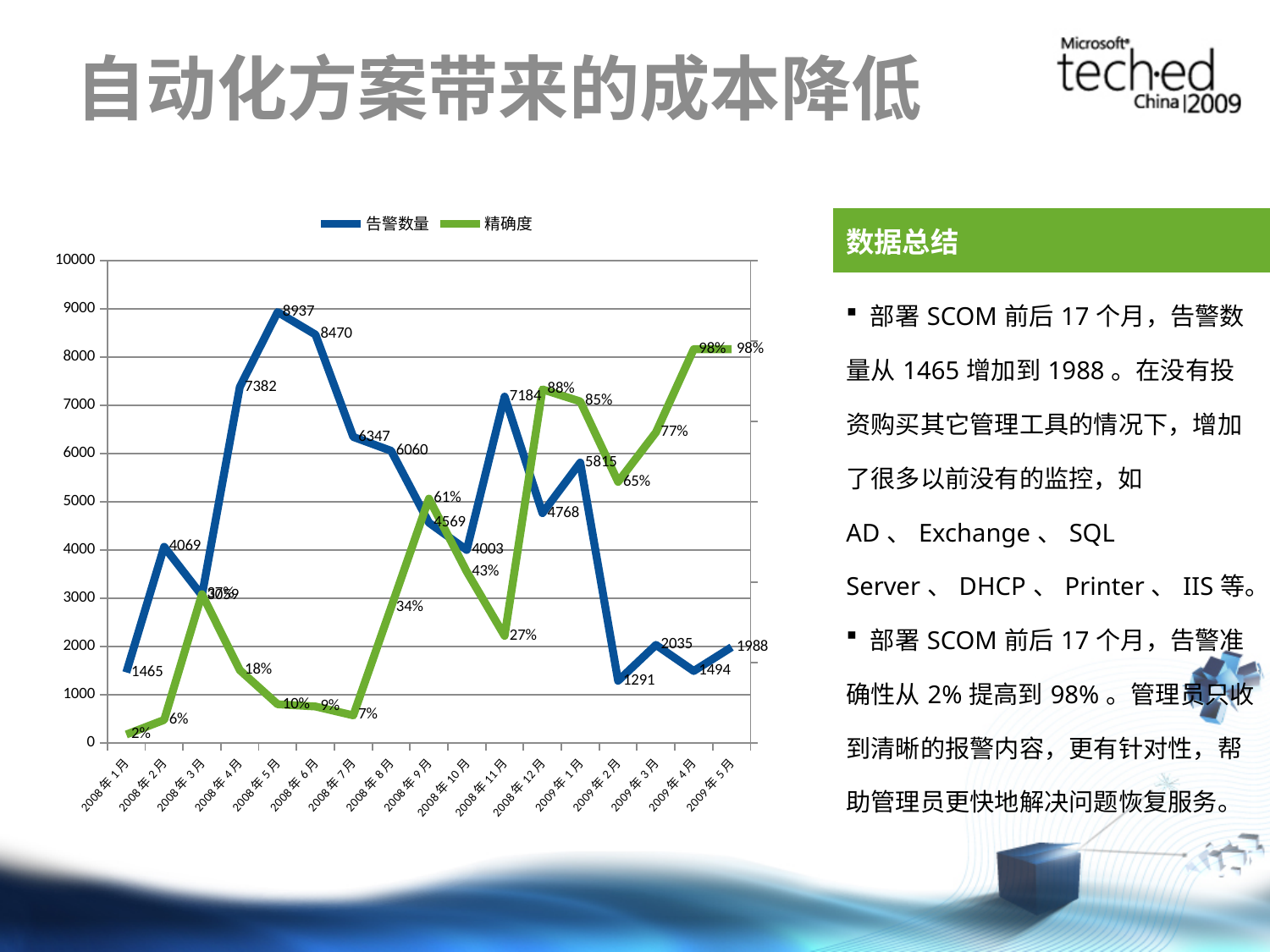
What is the difference between the 告警数量 values for 2009年5月 and 2008年1月? 523 What is the 精确度 value for 2008年9月? 61% What kind of chart is shown on the slide? line chart What is the 告警数量 value for 2008年5月? 8937 In which month is 告警数量 highest? 2008年5月 How many months are plotted along the x axis? 17 In which month is 精确度 lowest? 2008年1月 Which month has the larger 告警数量 value, 2008年11月 or 2009年1月? 2008年11月 What are the two series named in the legend? 告警数量 and 精确度 How many series does the chart legend list? 2 What is the 精确度 value for 2009年5月? 98% In which month is 告警数量 lowest? 2009年2月